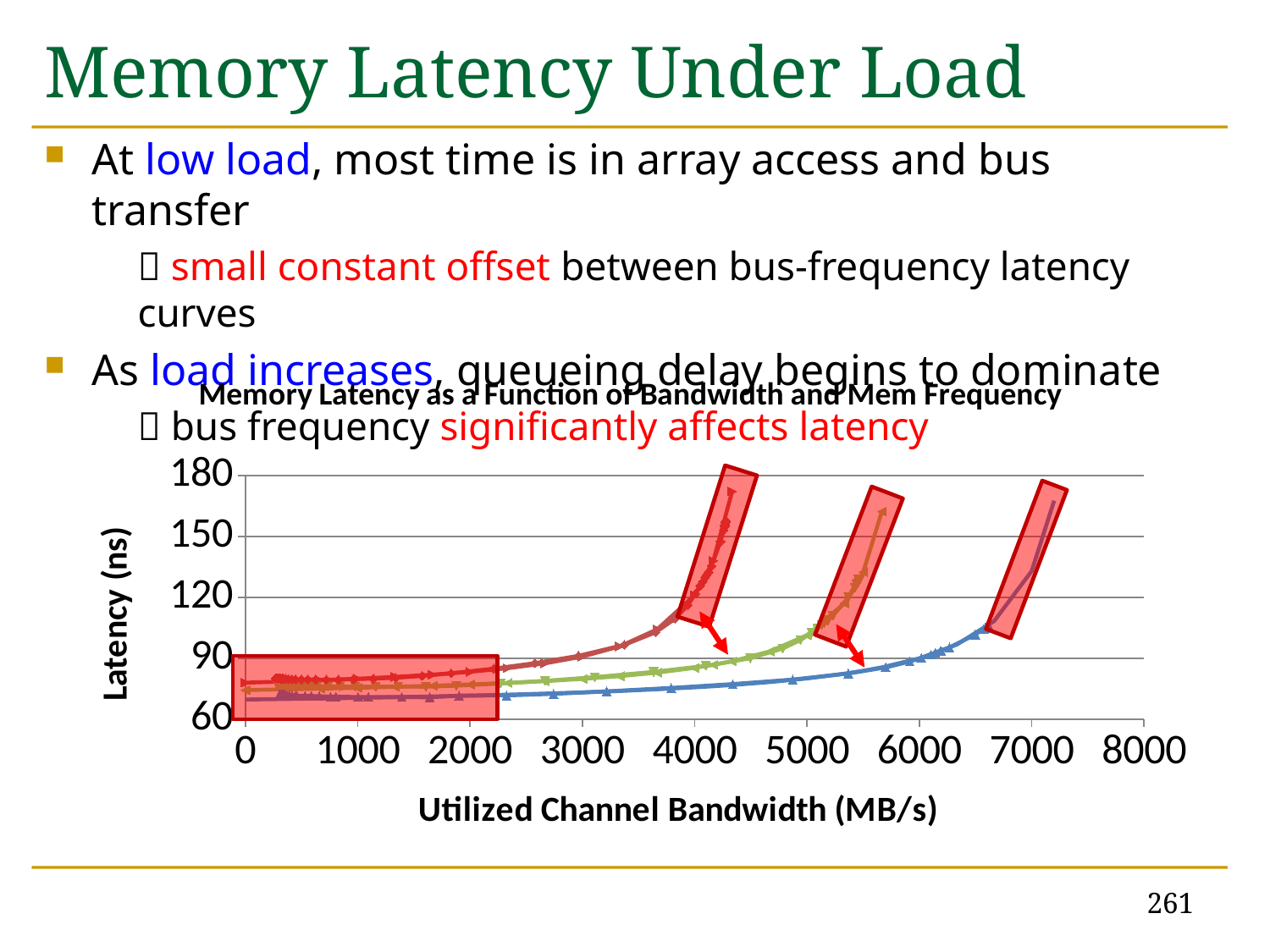
How many lines (series) are plotted on the chart? 6 Which curve reaches the highest utilized channel bandwidth before its latency shoots up? blue curve What is the label of the y axis of the chart? Latency (ns) Which curve's latency shoots up at the lowest utilized channel bandwidth? red curve Is the latency of the blue curve at 2000 MB/s greater or less than 90 ns? less At 4000 MB/s, which curve has the higher latency, the red curve or the blue curve? red curve Is the latency of the blue curve at 4000 MB/s greater or less than 90 ns? less Is the latency of the red curve at 4000 MB/s greater or less than 90 ns? greater What kind of chart is shown on the slide? line chart What is the title of the chart? Memory Latency as a Function of Bandwidth and Mem Frequency Does latency rise or fall as utilized channel bandwidth increases along the x axis? rise